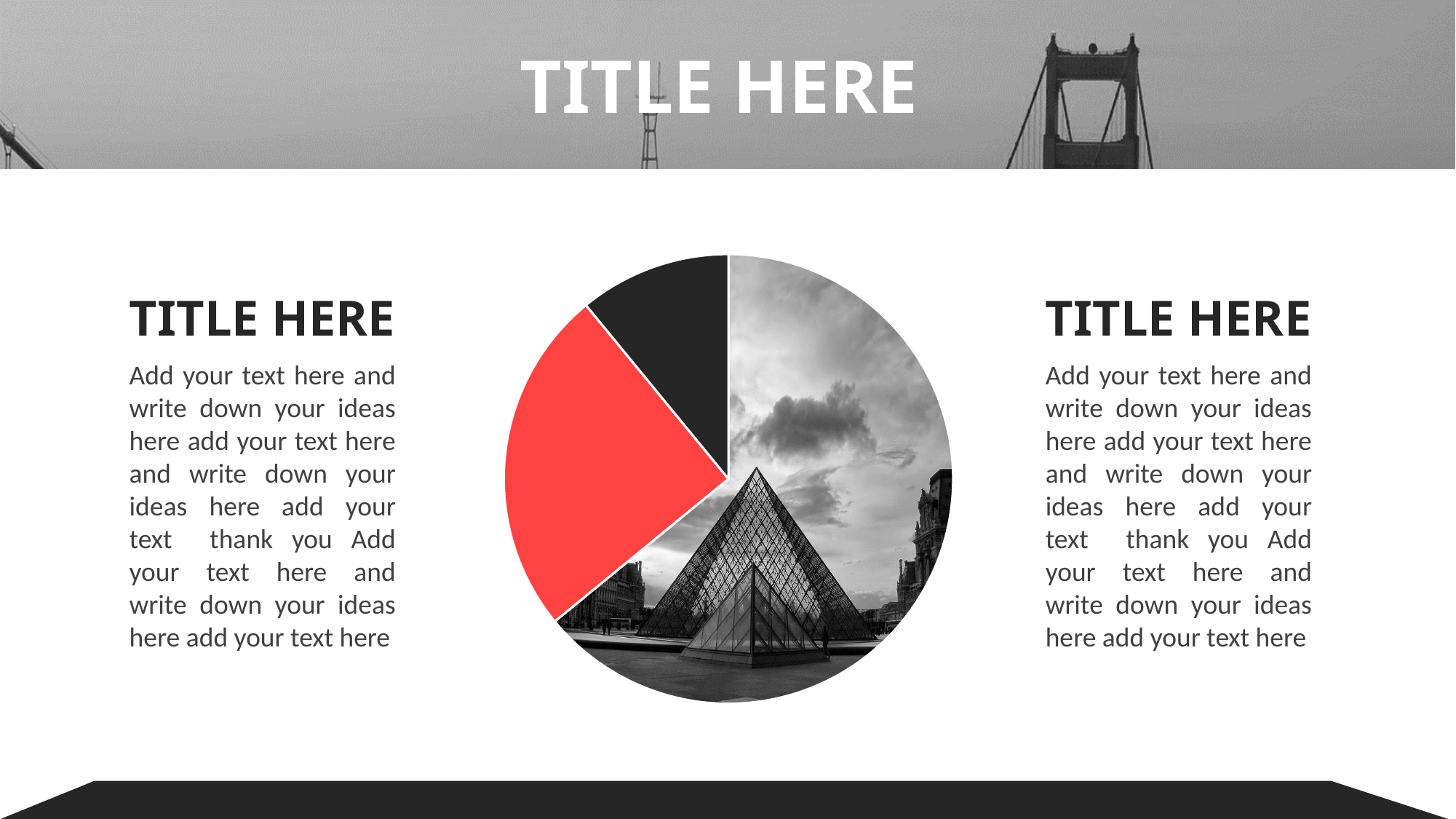
In the pie chart, which is larger, the photo-filled slice or the red slice? the photo-filled slice Which slice of the pie chart is the largest: the photo-filled slice, the red slice, or the black slice? the photo-filled slice Does the pie chart show any data labels with values? No What kind of chart is shown in the centre of the slide? pie chart How many slices does the pie chart have? 3 In the pie chart, which is larger, the red slice or the black slice? the red slice Does the pie chart display a legend? No Which slice of the pie chart is the smallest: the photo-filled slice, the red slice, or the black slice? the black slice